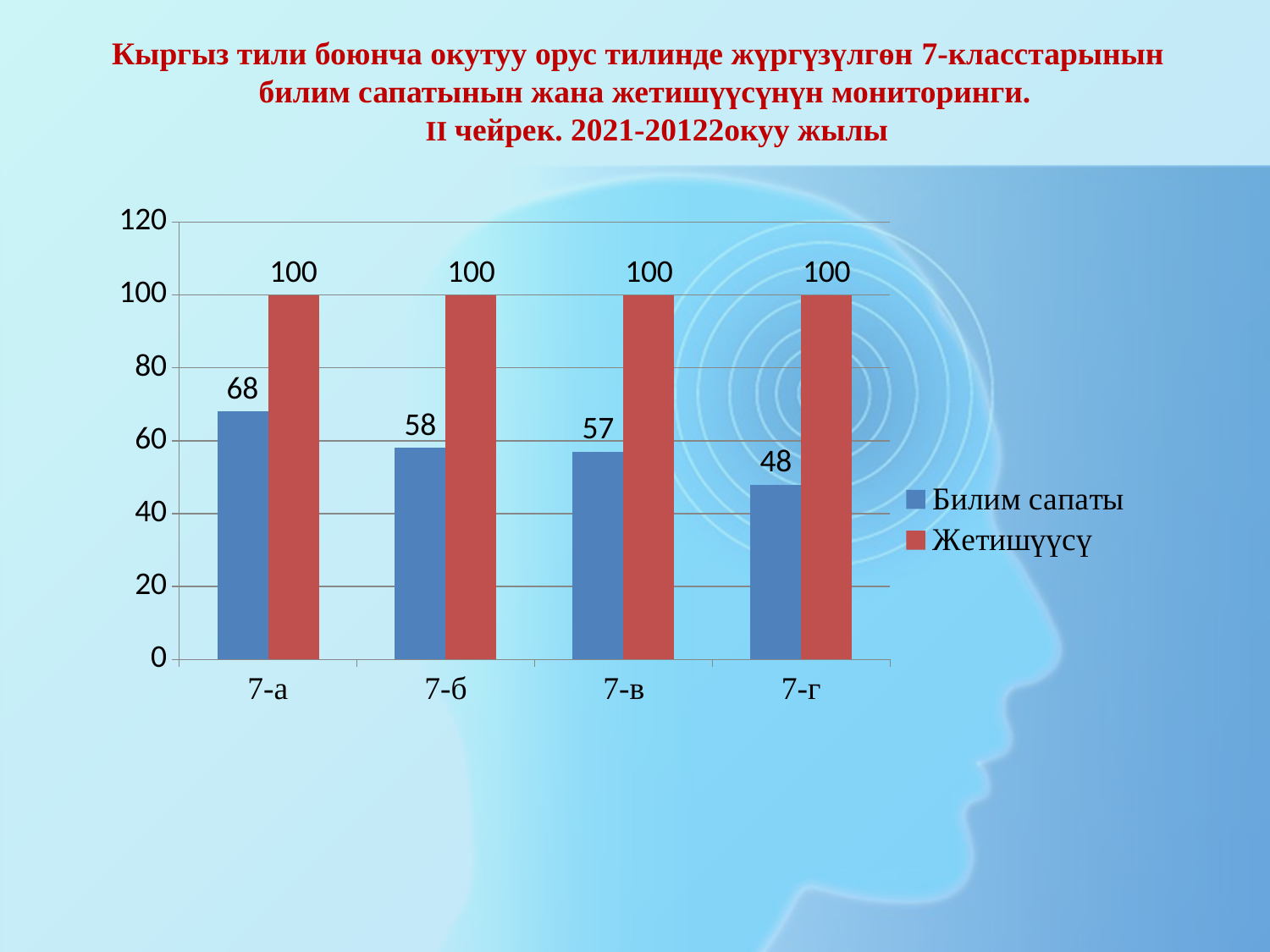
How many classes are shown on the x axis? 4 Which class has the highest Билим сапаты value? 7-а What is the difference between the Билим сапаты values for 7-а and 7-г? 20 Which is larger, the Билим сапаты value for 7-б or for 7-в? 7-б What is the value of Жетишүүсү for 7-б? 100 What is the value of Билим сапаты for 7-г? 48 What is the value of Билим сапаты for 7-а? 68 What is the difference between Жетишүүсү and Билим сапаты for 7-б? 42 What kind of chart is shown on the slide? bar chart How many series does the legend list? 2 Do the Билим сапаты values rise or fall from 7-а to 7-г? fall Which class has the lowest Билим сапаты value? 7-г